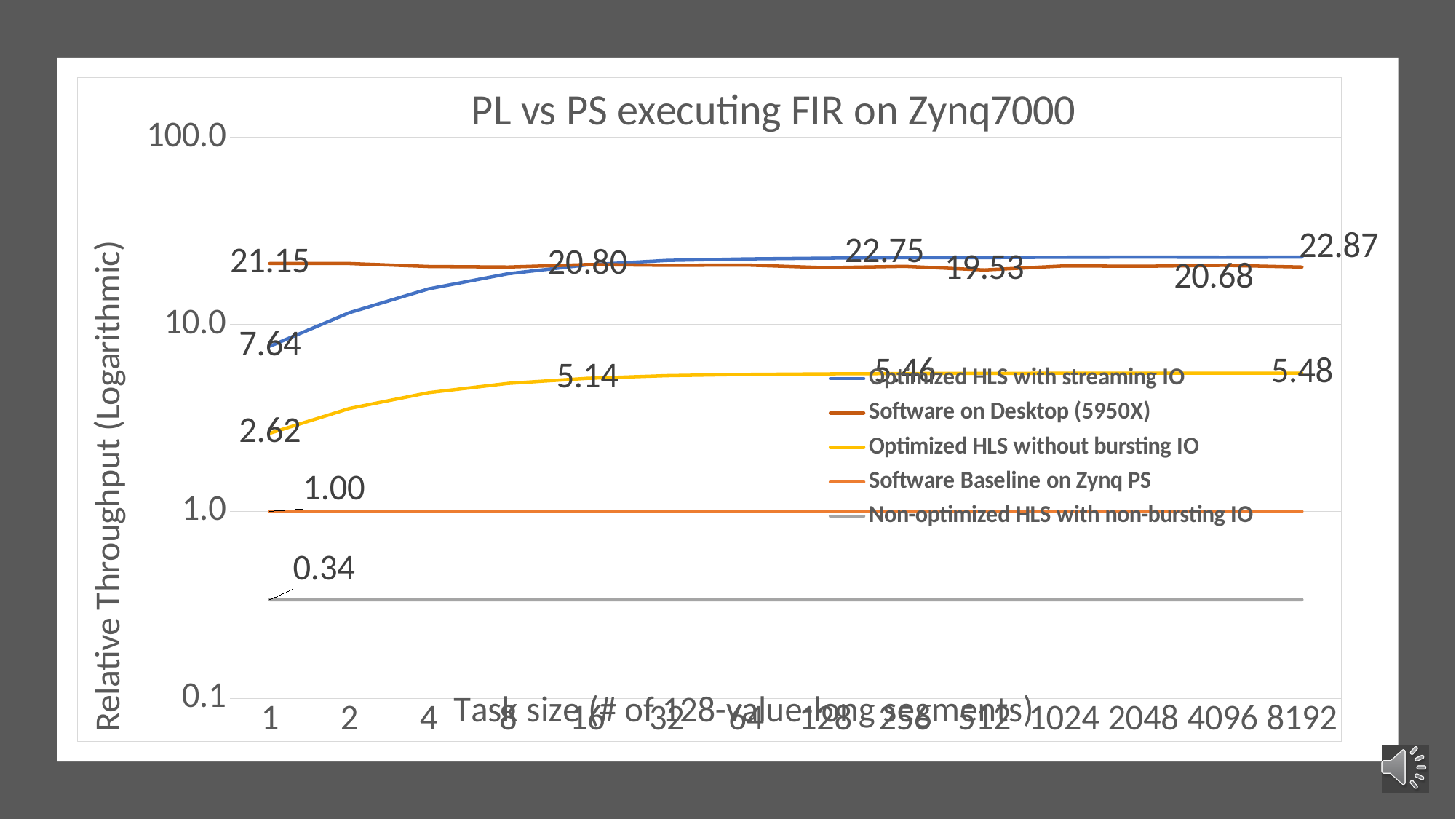
How many series does the legend list? 5 What value is labelled on the Non-optimized HLS with non-bursting IO line? 0.34 Does the Optimized HLS with streaming IO line rise or fall as task size increases? rises How many task-size values are shown along the x axis? 14 What is the relative throughput of Optimized HLS with streaming IO at task size 8192? 22.87 Is the value for Non-optimized HLS with non-bursting IO greater or less than 1.0? less What is the difference between Optimized HLS with streaming IO and Optimized HLS without bursting IO at task size 8192? 17.39 What is the relative throughput of Optimized HLS with streaming IO at task size 1? 7.64 What is the relative throughput of Optimized HLS without bursting IO at task size 1? 2.62 What is the relative throughput of Optimized HLS without bursting IO at task size 8192? 5.48 What kind of chart is shown on the slide? line chart At task size 1, which is larger: Software on Desktop (5950X) or Optimized HLS with streaming IO? Software on Desktop (5950X)